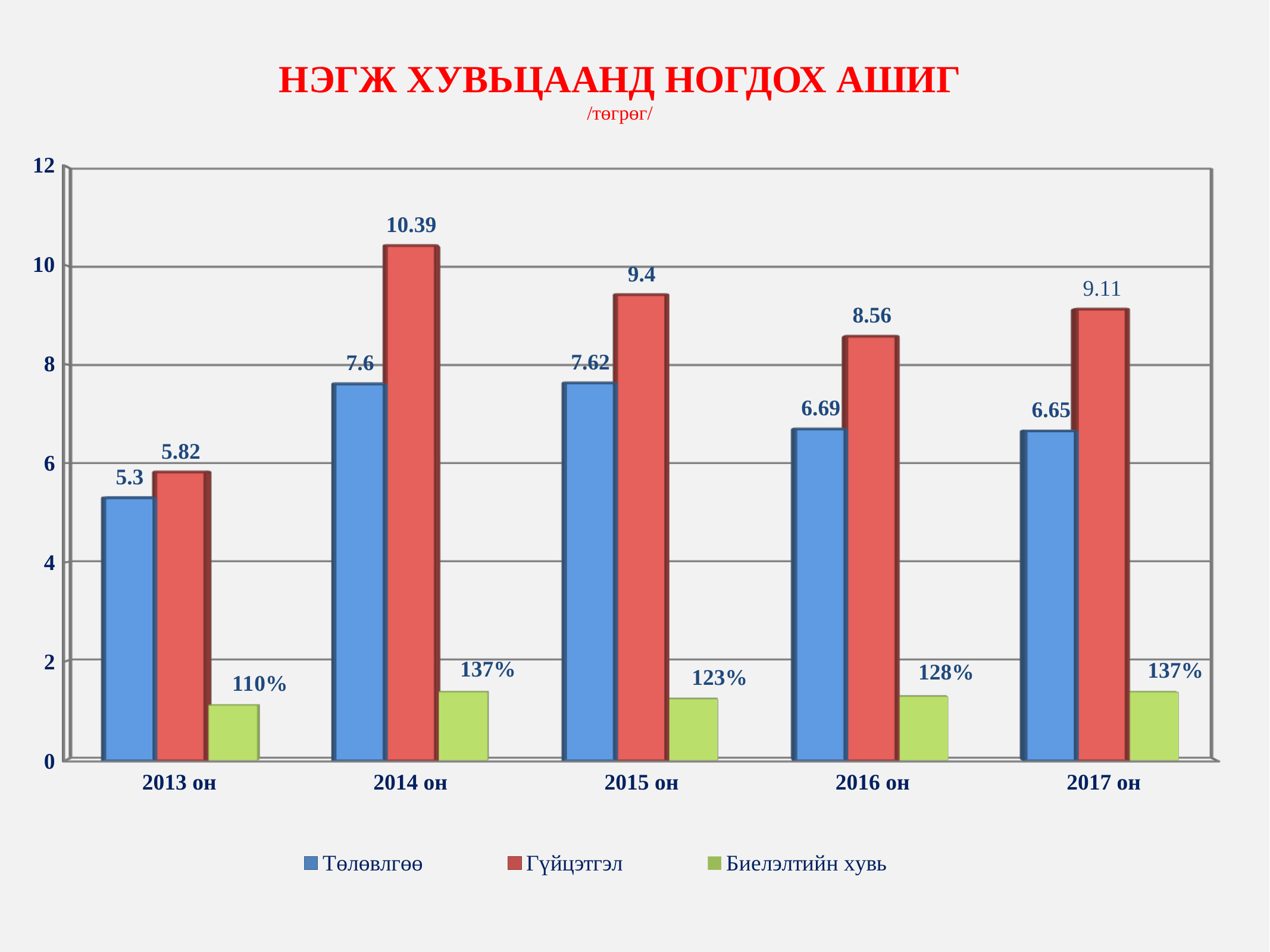
Is the Гүйцэтгэл value for 2015 он greater or less than 8? greater In which year is Гүйцэтгэл highest? 2014 он What unit is given in the subtitle under the chart title? төгрөг How many years are shown on the x axis? 5 Which is larger for 2017 он, Төлөвлгөө or Гүйцэтгэл? Гүйцэтгэл What is the value of Төлөвлгөө for 2013 он? 5.3 What is the difference between Гүйцэтгэл and Төлөвлгөө for 2016 он? 1.87 How many series does the legend list? 3 What is the Биелэлтийн хувь value for 2015 он? 123% What kind of chart is shown on the slide? Bar chart What is the value of Гүйцэтгэл for 2014 он? 10.39 In which year is Төлөвлгөө lowest? 2013 он